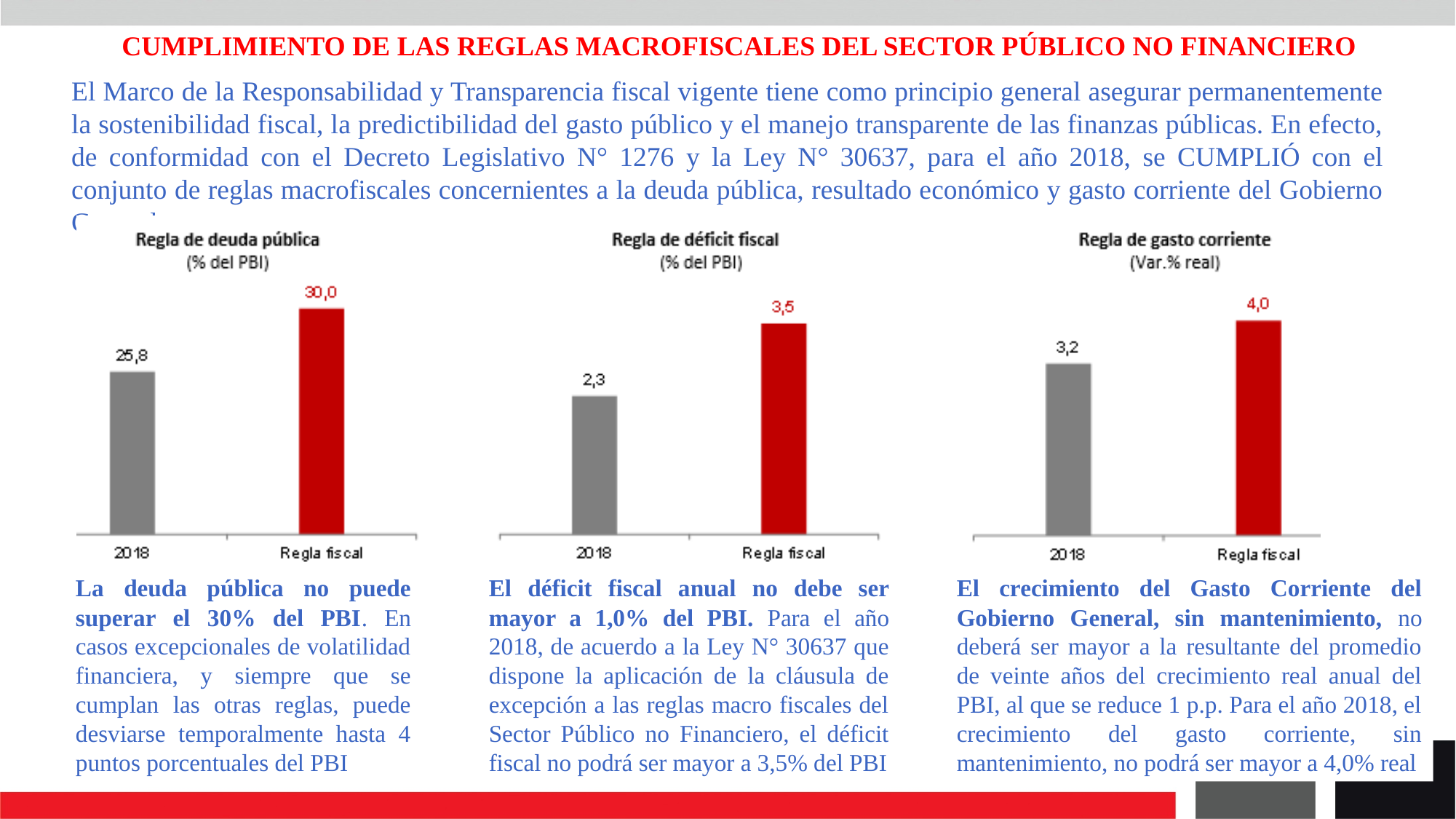
In the 'Regla de déficit fiscal' chart, what is the difference between the Regla fiscal value and the 2018 value? 1,2 In the 'Regla de gasto corriente' chart, what is the value for Regla fiscal? 4,0 In the 'Regla de gasto corriente' chart, what is the value for 2018? 3,2 In the 'Regla de déficit fiscal' chart, which category has the lowest value? 2018 In the 'Regla de déficit fiscal' chart, what is the value for Regla fiscal? 3,5 What kind of chart is the 'Regla de deuda pública' chart? Bar chart In the 'Regla de deuda pública' chart, what is the value for 2018? 25,8 In the 'Regla de deuda pública' chart, what is the difference between the Regla fiscal value and the 2018 value? 4,2 In the 'Regla de gasto corriente' chart, which category has the higher value, 2018 or Regla fiscal? Regla fiscal In the 'Regla de deuda pública' chart, what is the value for Regla fiscal? 30,0 In the 'Regla de déficit fiscal' chart, what is the value for 2018? 2,3 How many bars are shown in the 'Regla de gasto corriente' chart? 2